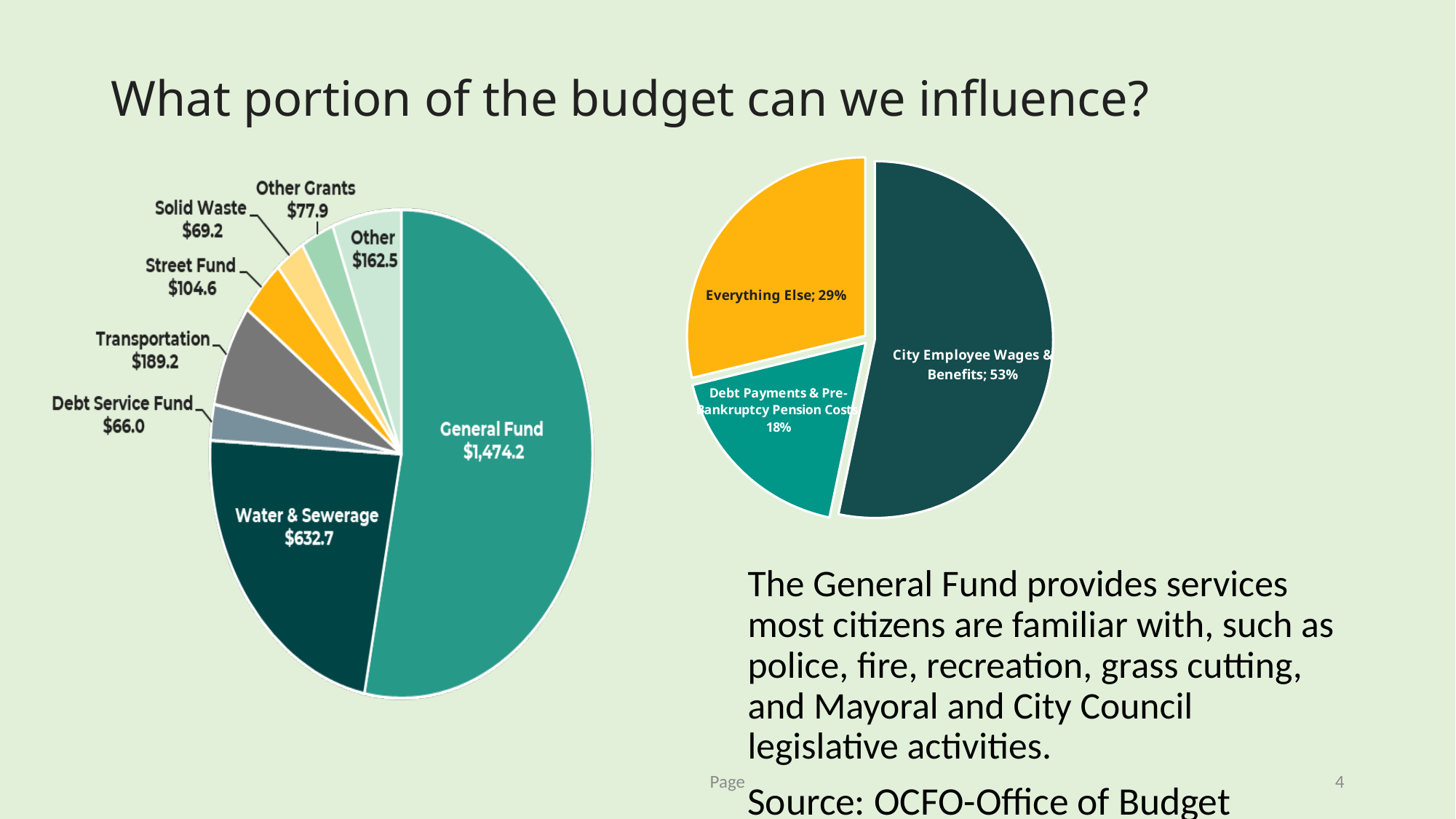
In the left pie chart, what is the value for the General Fund? $1,474.2 In the left pie chart, what is the difference between the General Fund and Water & Sewerage values? $841.5 In the left pie chart, what is the value for Transportation? $189.2 In the right pie chart, what share is City Employee Wages & Benefits? 53% In the left pie chart, which is larger, Street Fund or Solid Waste? Street Fund In the right pie chart, which slice is the smallest? Debt Payments & Pre-Bankruptcy Pension Costs In the right pie chart, what share is Debt Payments & Pre-Bankruptcy Pension Costs? 18% In the left pie chart, which category has the smallest value? Debt Service Fund How many slices does the left pie chart have? 8 In the left pie chart, which category has the largest value? General Fund What type of chart is the right chart on the slide? Pie chart In the left pie chart, what is the value for Water & Sewerage? $632.7